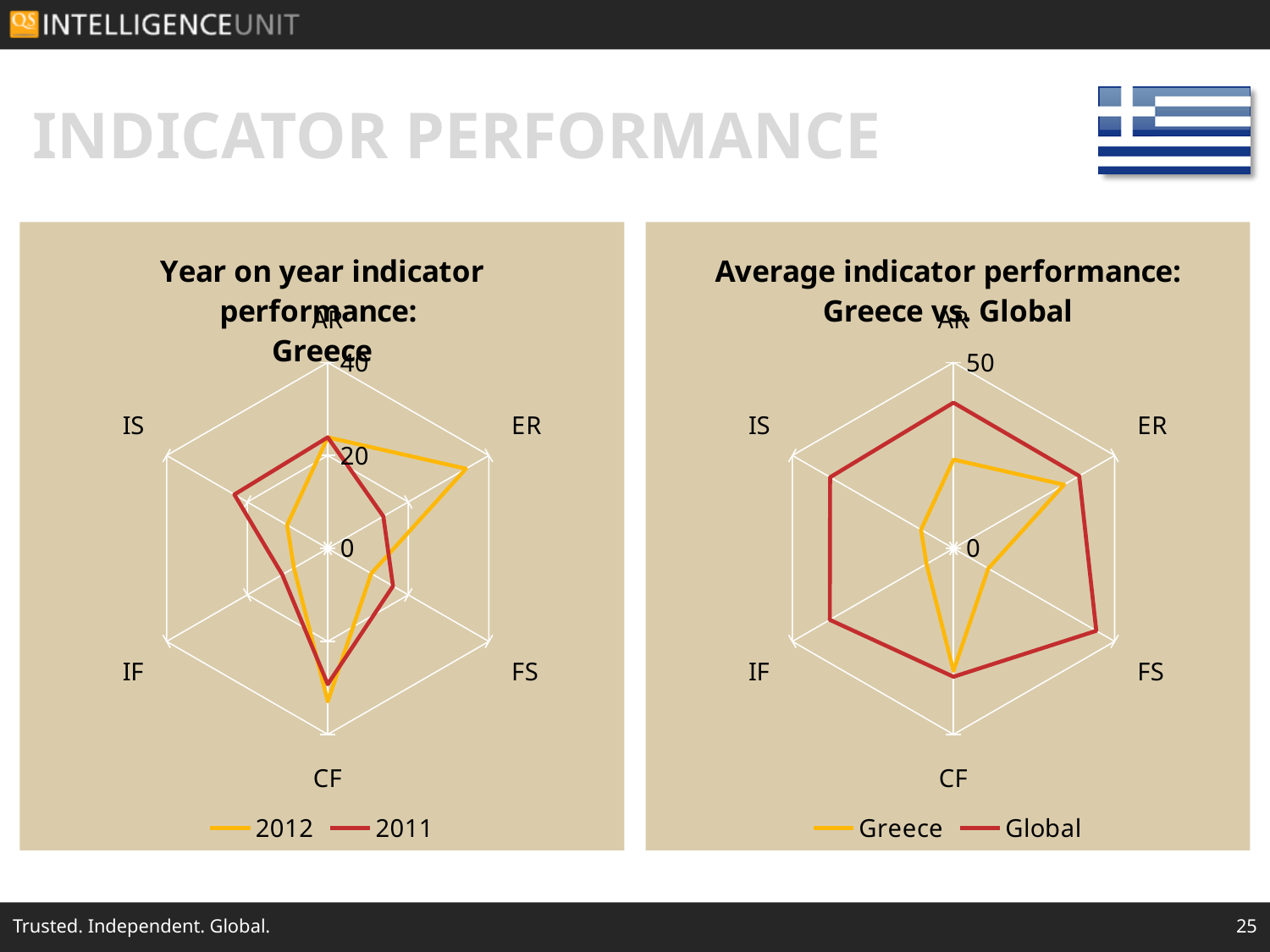
On the 'Year on year indicator performance: Greece' chart, is the 2012 value for IF greater or less than 20? less On the 'Average indicator performance: Greece vs Global' chart, which series has the larger value for IF, Greece or Global? Global On the 'Year on year indicator performance: Greece' chart, which series has the larger value for ER, 2012 or 2011? 2012 Which two series are shown in the legend of the 'Average indicator performance: Greece vs Global' chart? Greece and Global What kind of chart is the 'Year on year indicator performance: Greece' chart? Radar chart On the 'Average indicator performance: Greece vs Global' chart, is the Global value for AR greater or less than 50? less On the 'Year on year indicator performance: Greece' chart, is the 2012 value for CF greater or less than 20? greater How many indicator categories are plotted on the 'Average indicator performance: Greece vs Global' chart? 6 On the 'Average indicator performance: Greece vs Global' chart, which series has the larger value for IS, Greece or Global? Global How many series does the legend of the 'Year on year indicator performance: Greece' chart list? 2